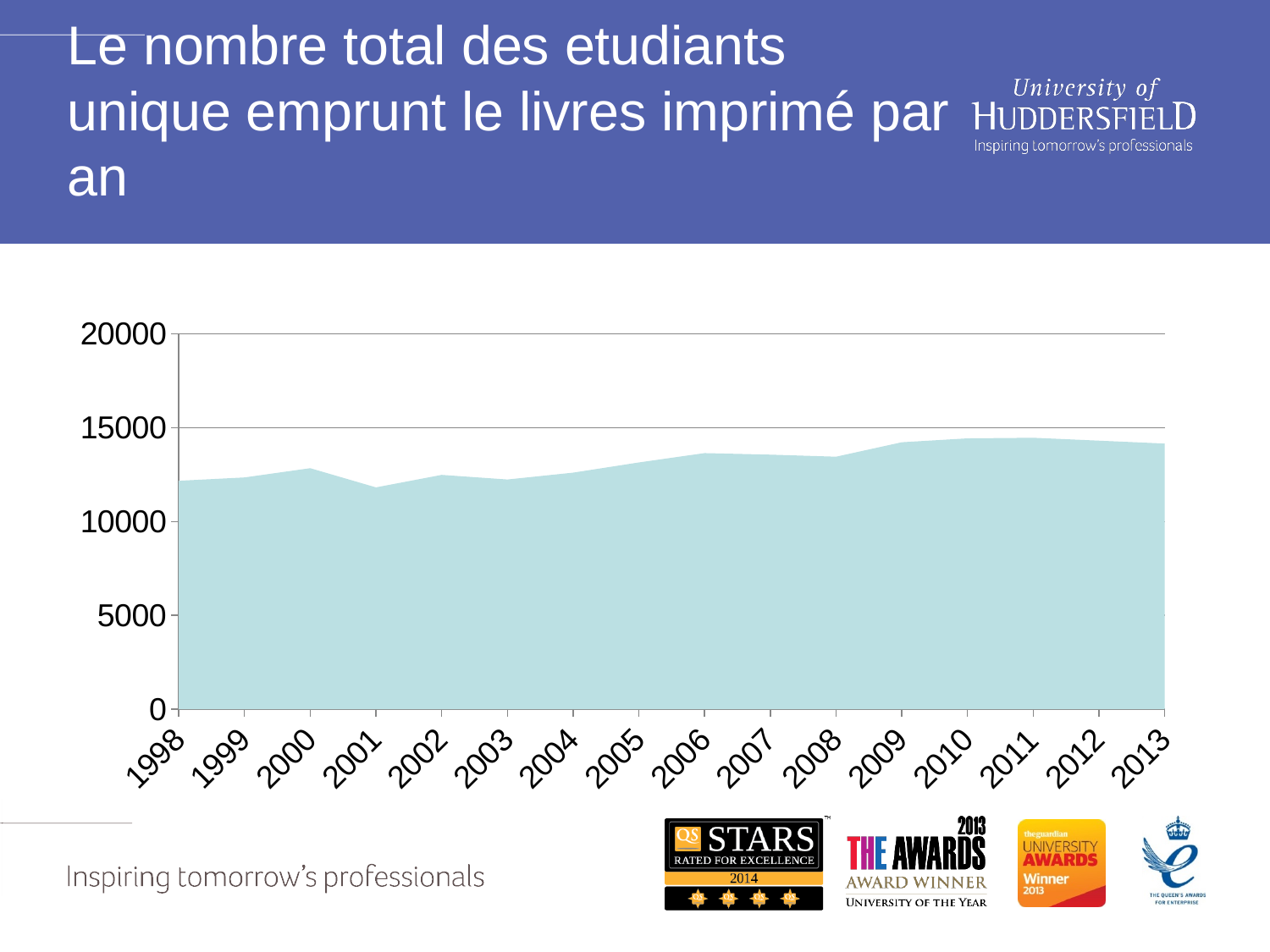
Is the value for 2001 greater or less than 15000? less What kind of chart is shown on the slide? area chart What is the first year shown on the x axis of the chart? 1998 Is the value for 2013 greater or less than 15000? less Overall, do the values rise or fall from 1998 to 2013? rise Which is larger, the value for 2001 or the value for 2010? 2010 Which year has the lowest value in the chart? 2001 Is the value for 2010 greater or less than 15000? less What is the last year shown on the x axis of the chart? 2013 How many years are shown along the x axis of the chart? 16